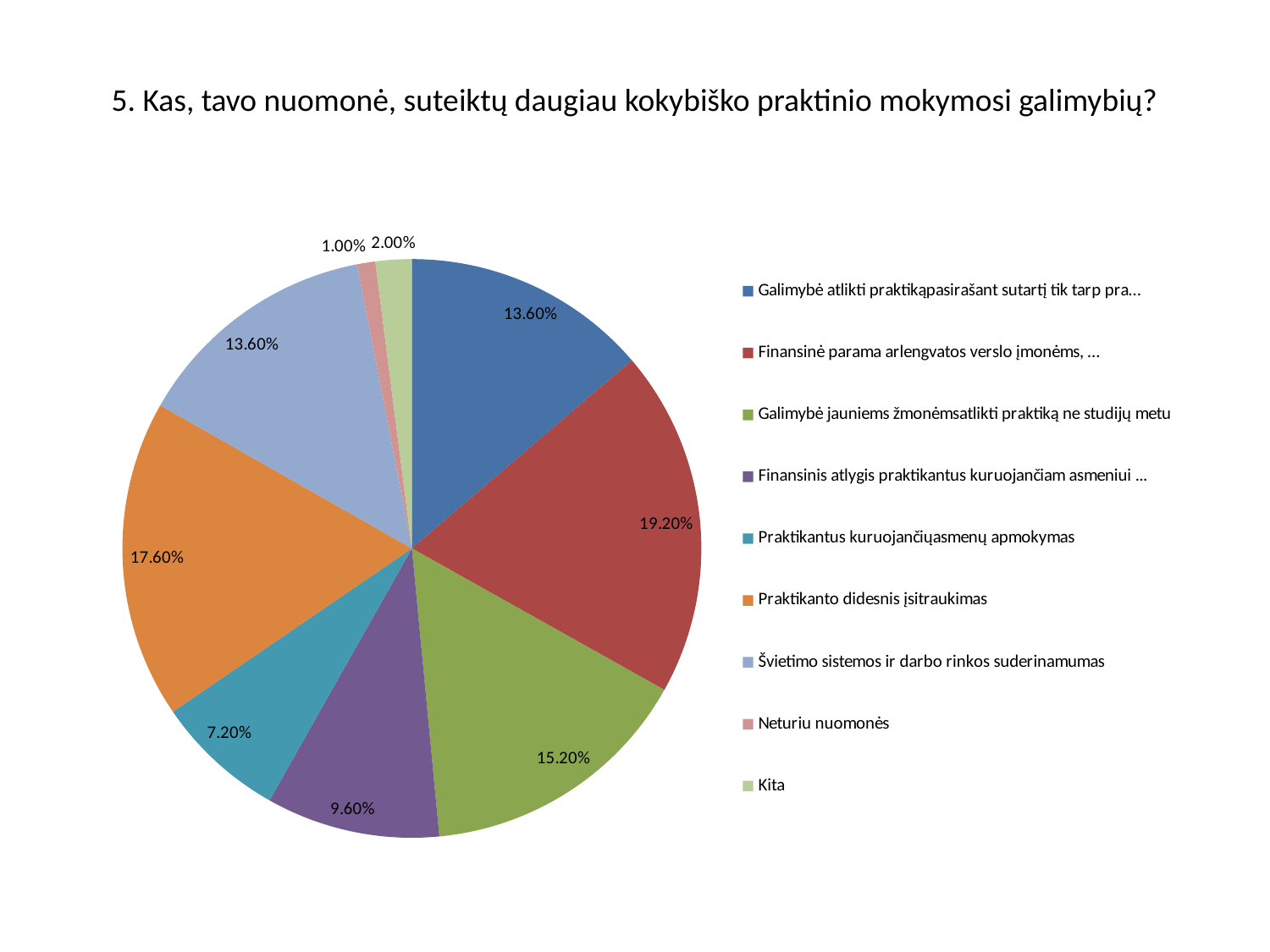
What percentage is shown for "Švietimo sistemos ir darbo rinkos suderinamumas"? 13.60% What percentage is shown for "Praktikantus kuruojančių asmenų apmokymas"? 7.20% What percentage is shown for "Galimybė jauniems žmonėms atlikti praktiką ne studijų metu"? 15.20% Which category has the smallest slice of the pie? Neturiu nuomonės Which slice is larger, "Kita" or "Neturiu nuomonės"? Kita How many slices does the pie chart have? 9 What percentage is shown for "Neturiu nuomonės"? 1.00% What is the value of the largest slice in the pie chart? 19.20% What percentage is shown for "Kita"? 2.00% What percentage is shown for "Praktikanto didesnis įsitraukimas"? 17.60% How much larger is the share for "Praktikanto didesnis įsitraukimas" than for "Švietimo sistemos ir darbo rinkos suderinamumas"? 4.00% What type of chart is shown on the slide? pie chart